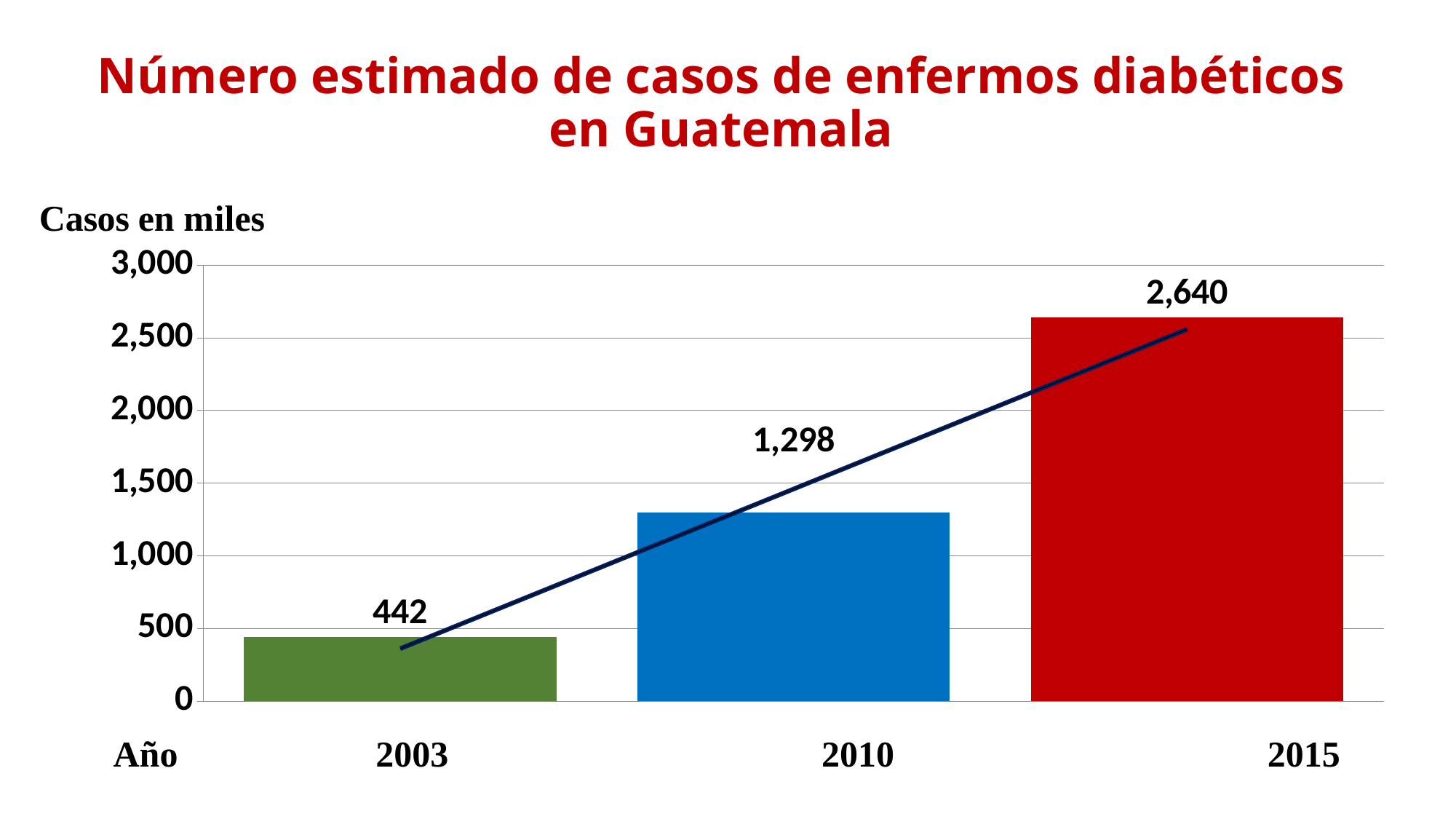
What is the value for 2003? 442 Is the value for 2010 greater or less than 1,500? less What kind of chart is this? bar chart Which is larger, the value for 2010 or the value for 2015? 2015 What is the difference between the values for 2015 and 2003? 2,198 Do the values rise or fall from 2003 to 2015? rise Which year has the highest value? 2015 How many years are shown on the x axis? 3 What is the value for 2015? 2,640 What is the difference between the values for 2010 and 2003? 856 Which year has the lowest value? 2003 What is the value for 2010? 1,298